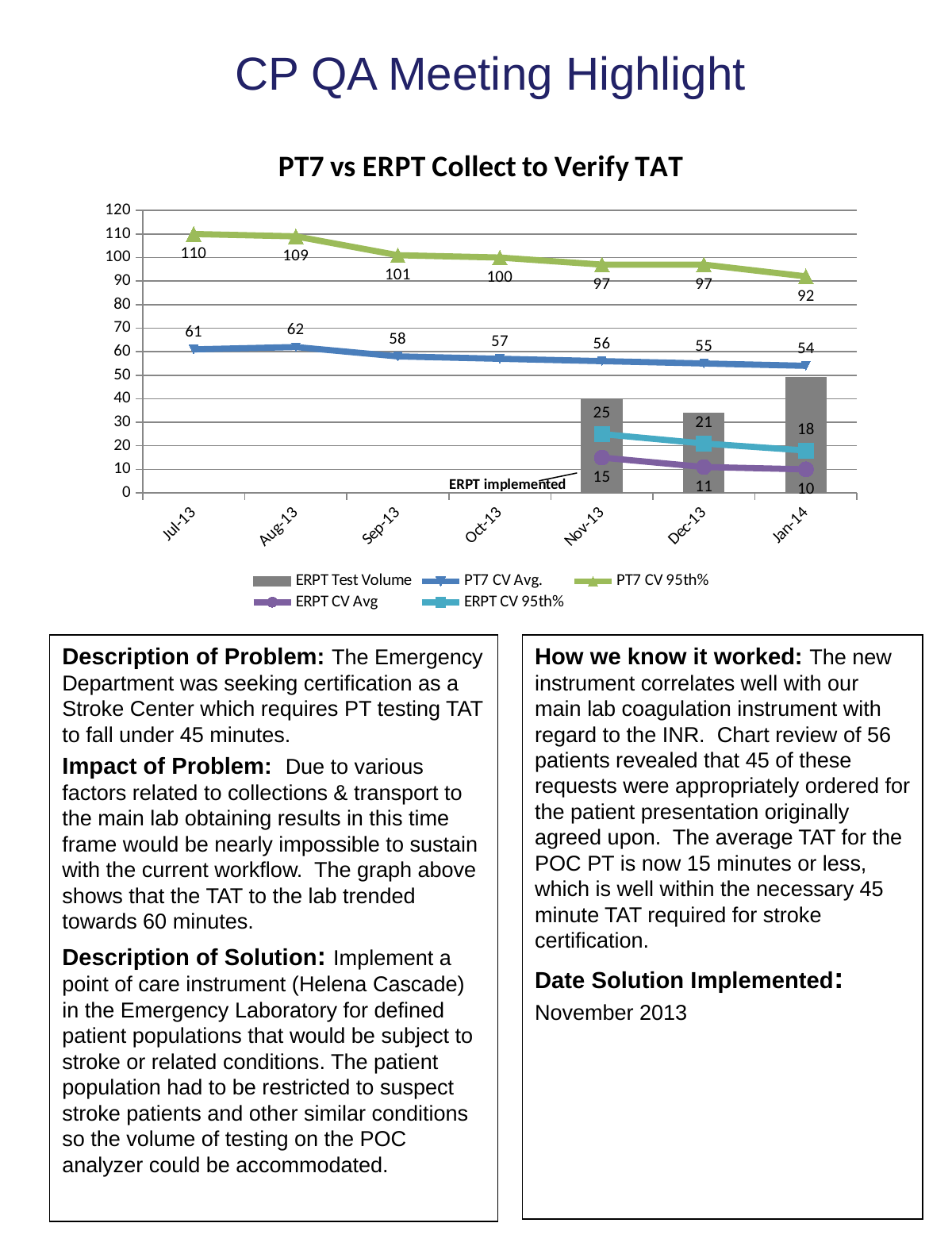
In which month is the PT7 CV Avg. value highest? Aug-13 What is the PT7 CV Avg. value for Jan-14? 54 What is the ERPT CV 95th% value for Nov-13? 25 What is the ERPT CV Avg value for Dec-13? 11 In which month is the PT7 CV 95th% value lowest? Jan-14 How many months are shown on the x axis? 7 Is the ERPT Test Volume bar for Jan-14 greater or less than 40? greater Does the PT7 CV Avg. series rise or fall from Jul-13 to Jan-14? fall How many series does the legend list? 5 What is the difference between the PT7 CV 95th% values for Jul-13 and Jan-14? 18 Which month has the larger ERPT CV 95th% value, Nov-13 or Dec-13? Nov-13 What is the PT7 CV 95th% value for Jul-13? 110